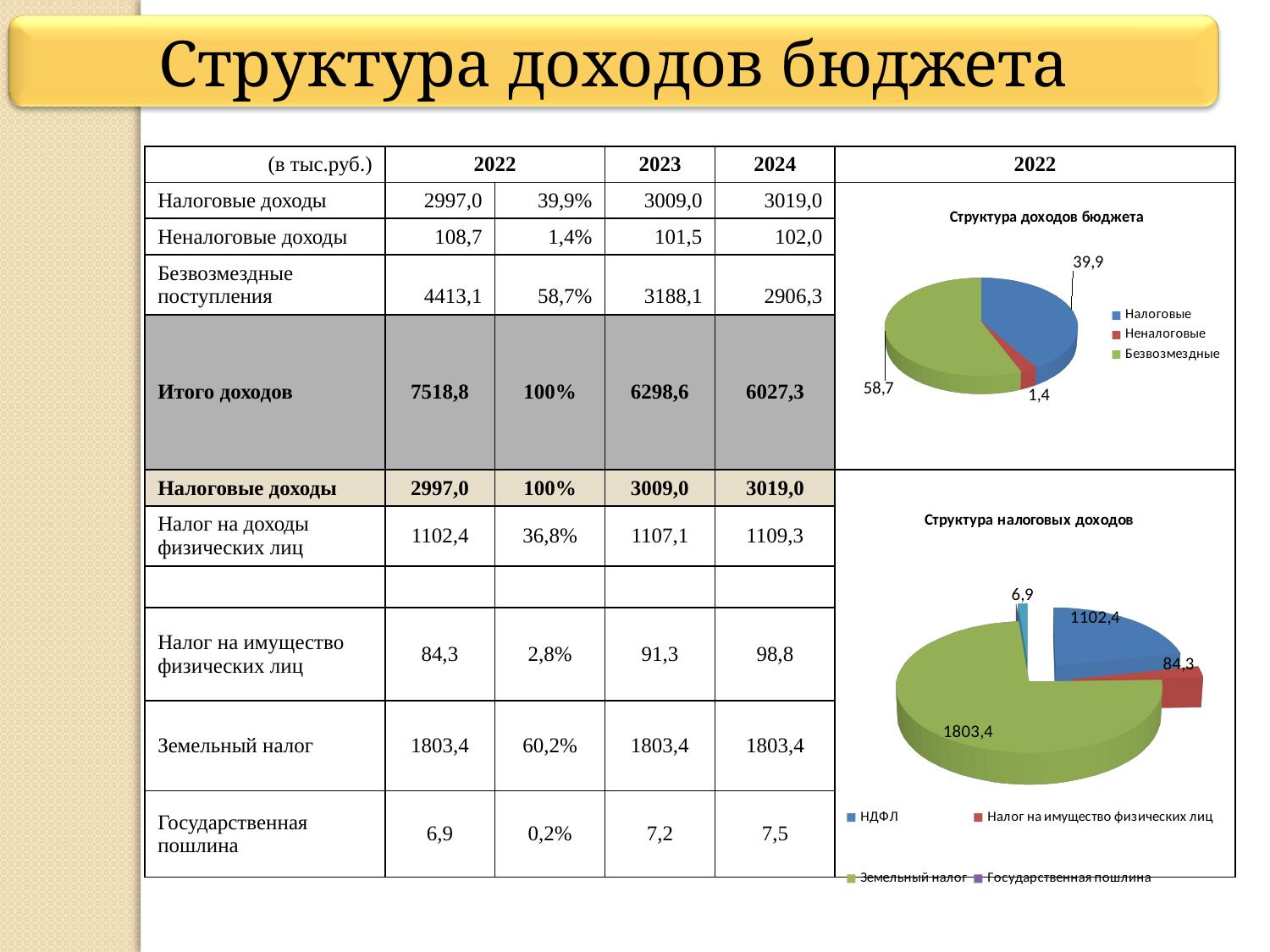
In the chart titled "Структура налоговых доходов", which category has the smallest slice? Государственная пошлина In the chart titled "Структура доходов бюджета", what is the value shown for Неналоговые? 1,4 In the chart titled "Структура налоговых доходов", what is the value shown for Налог на имущество физических лиц? 84,3 In the chart titled "Структура доходов бюджета", which category has the smallest slice? Неналоговые In the chart titled "Структура налоговых доходов", which is larger: НДФЛ or Земельный налог? Земельный налог In the chart titled "Структура доходов бюджета", how many categories does the legend list? 3 What kind of chart is the chart titled "Структура доходов бюджета"? pie chart In the chart titled "Структура налоговых доходов", what is the value shown for Земельный налог? 1803,4 In the chart titled "Структура налоговых доходов", what is the difference between the values for Земельный налог and НДФЛ? 701,0 In the chart titled "Структура доходов бюджета", which category has the largest slice? Безвозмездные In the chart titled "Структура доходов бюджета", what is the value shown for Налоговые? 39,9